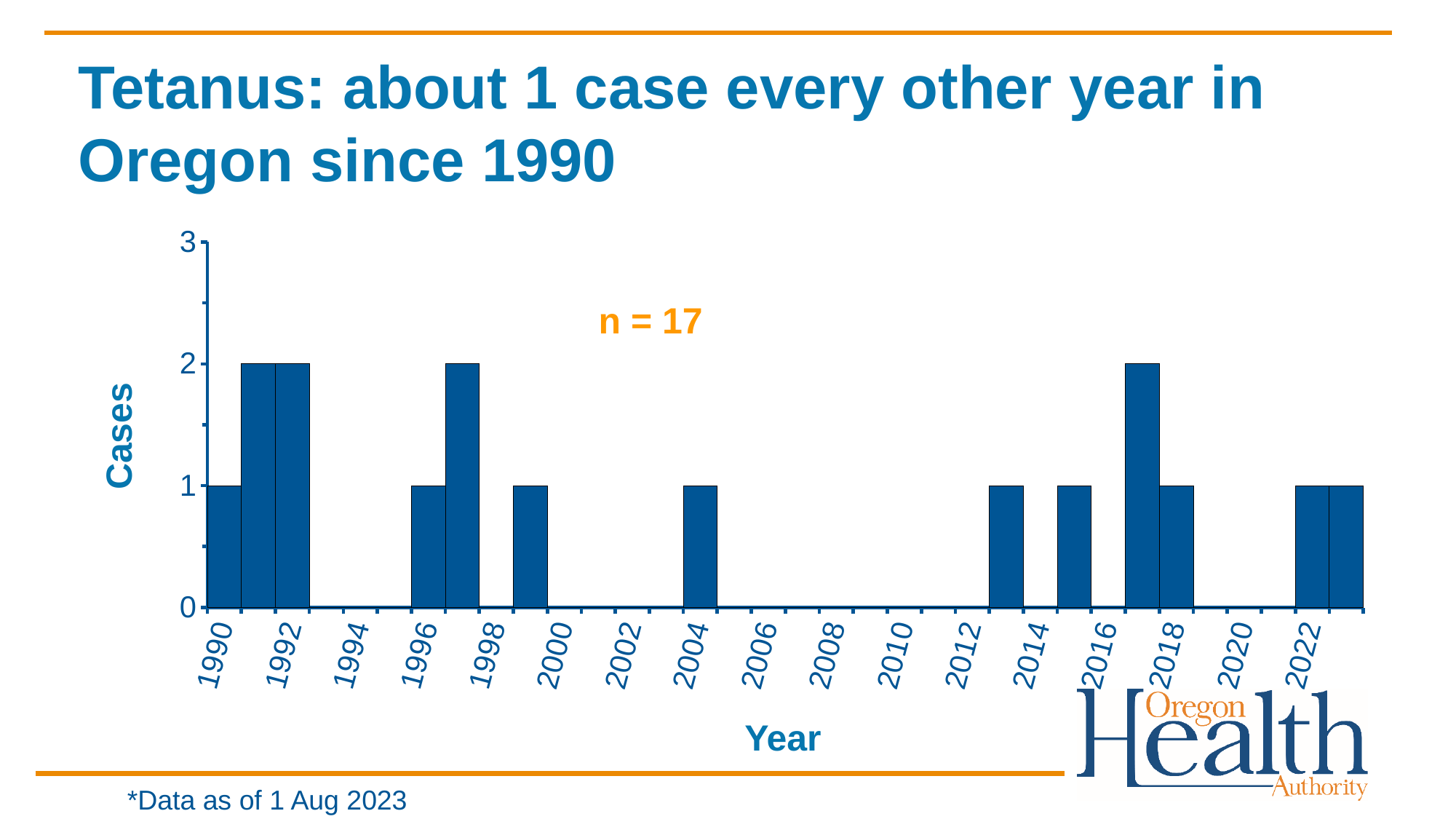
What is the highest number of cases reported in any single year on the chart? 2 How many tetanus cases were reported in 2010? 0 How many tetanus cases were reported in 2004? 1 What type of chart is shown on the slide? bar chart What is the difference in cases between 1991 and 1990? 1 How many tetanus cases were reported in 2017? 2 Which year had more cases, 1997 or 1999? 1997 How many tetanus cases were reported in 1997? 2 What is the total number of cases shown on the chart (n)? 17 What is the label on the y-axis? Cases How many years on the chart have 2 cases? 4 How many tetanus cases were reported in 1991? 2